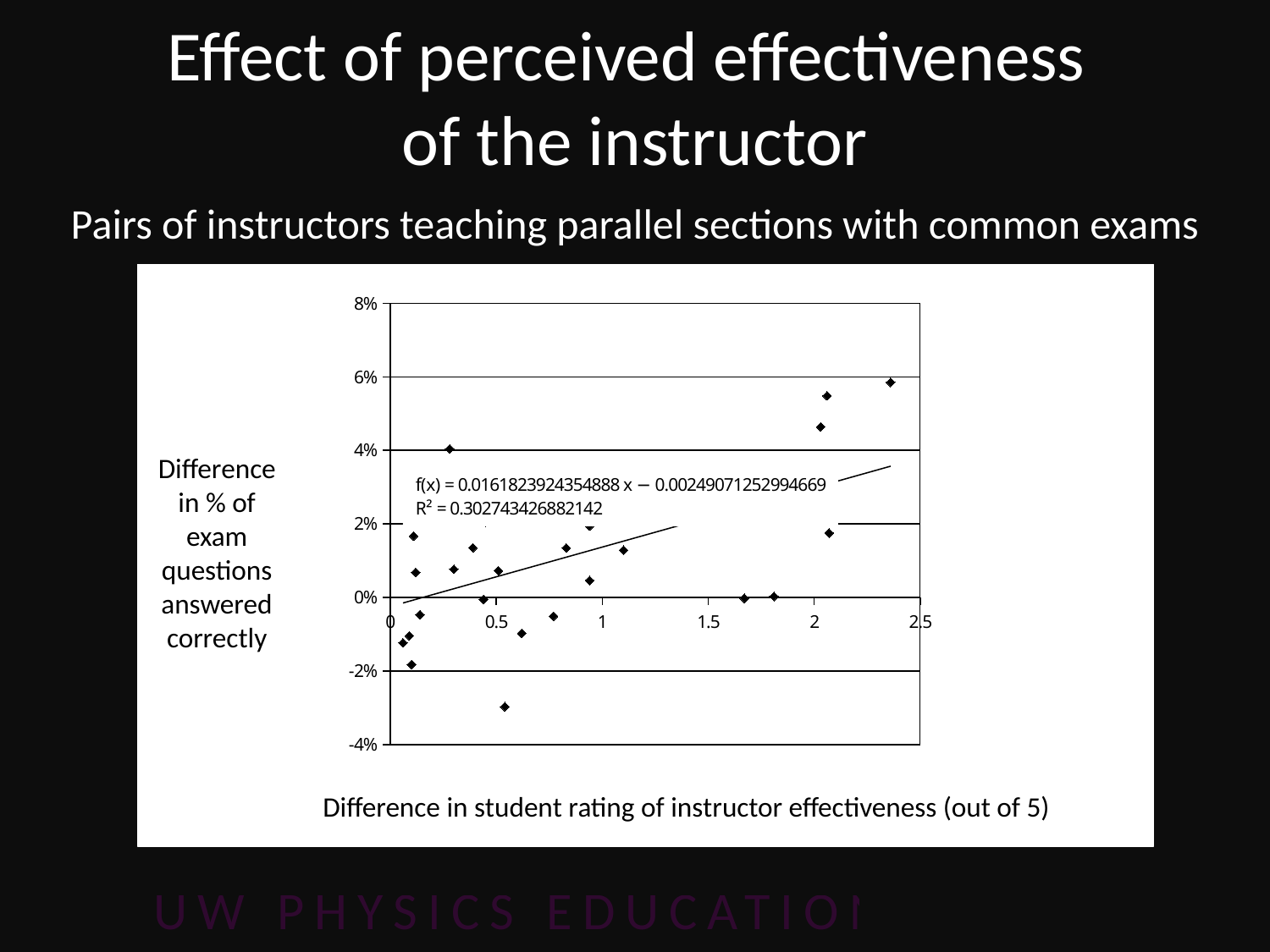
What is the maximum value shown on the vertical axis? 8% What is the R² value printed on the chart? 0.302743426882142 Is the highest plotted point on the chart greater or less than 4%? greater What is the slope of the fitted line shown in the equation on the chart? 0.0161823924354888 What is the intercept of the fitted line shown in the equation on the chart? −0.00249071252994669 Is the lowest plotted point on the chart greater or less than -2%? less What is the label of the horizontal axis? Difference in student rating of instructor effectiveness (out of 5) What kind of chart is shown on the slide? scatter plot Do the plotted points generally rise or fall as the difference in student rating increases along the x axis? rise What is the largest value shown on the horizontal axis? 2.5 Is the point plotted at the far right of the chart (near x = 2.35) greater or less than 4%? greater